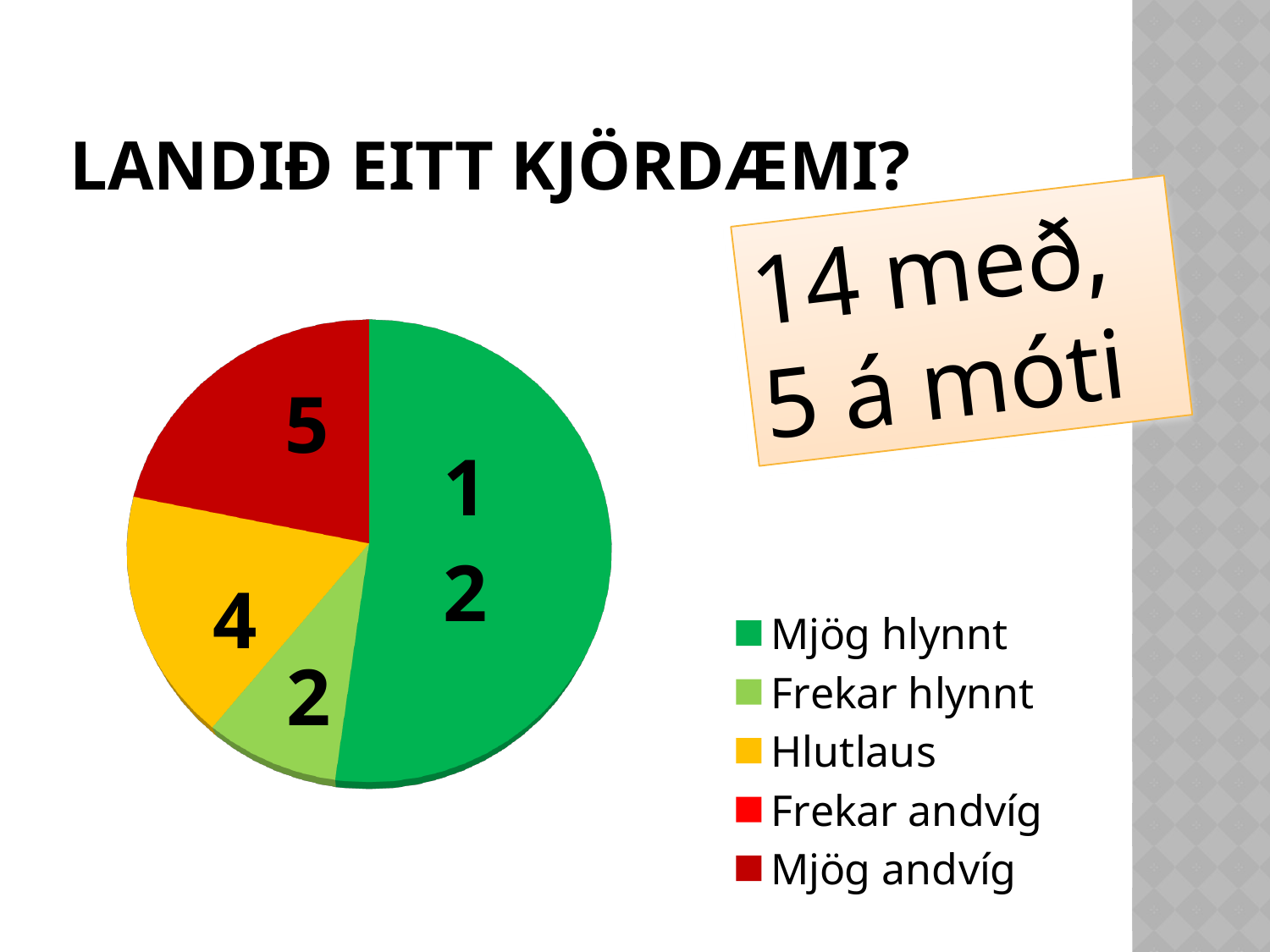
What kind of chart is shown on the slide? pie chart What is the difference between the values for Hlutlaus and Frekar hlynnt? 2 What colour is the Hlutlaus slice in the pie chart? yellow What is the value for Hlutlaus in the pie chart? 4 Which is larger, the value for Hlutlaus or the value for Mjög andvíg? Mjög andvíg What is the value for Mjög hlynnt in the pie chart? 12 What is the value for Mjög andvíg in the pie chart? 5 How many entries does the legend of the pie chart list? 5 Which category has the largest slice of the pie chart? Mjög hlynnt Which labeled slice of the pie chart is the smallest? Frekar hlynnt What is the difference between the values for Mjög hlynnt and Mjög andvíg? 7 What is the value for Frekar hlynnt in the pie chart? 2